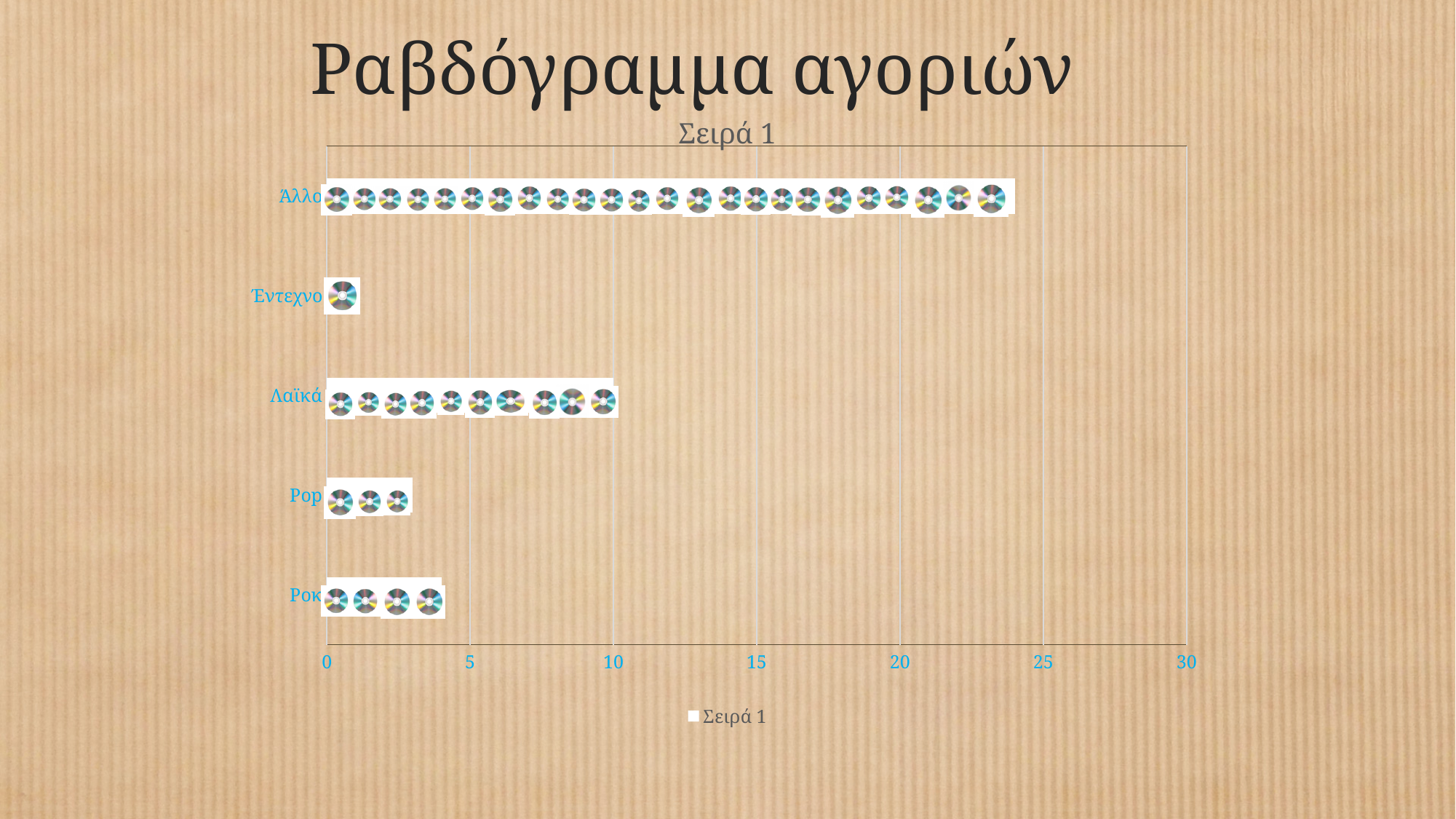
Is the value for Άλλο greater or less than 25? less Which category has the highest value? Άλλο How many categories are shown on the chart? 5 Which is larger, the value for Λαϊκά or the value for Έντεχνο? Λαϊκά Which is larger, the value for Ροκ or the value for Pop? Ροκ Is the value for Pop greater or less than 5? less What is the title of the slide? Ραβδόγραμμα αγοριών Is the value for Άλλο greater or less than 20? greater How many series does the legend list? 1 Which category has the lowest value? Έντεχνο What is the value for Λαϊκά? 10 What kind of chart is shown on the slide? bar chart